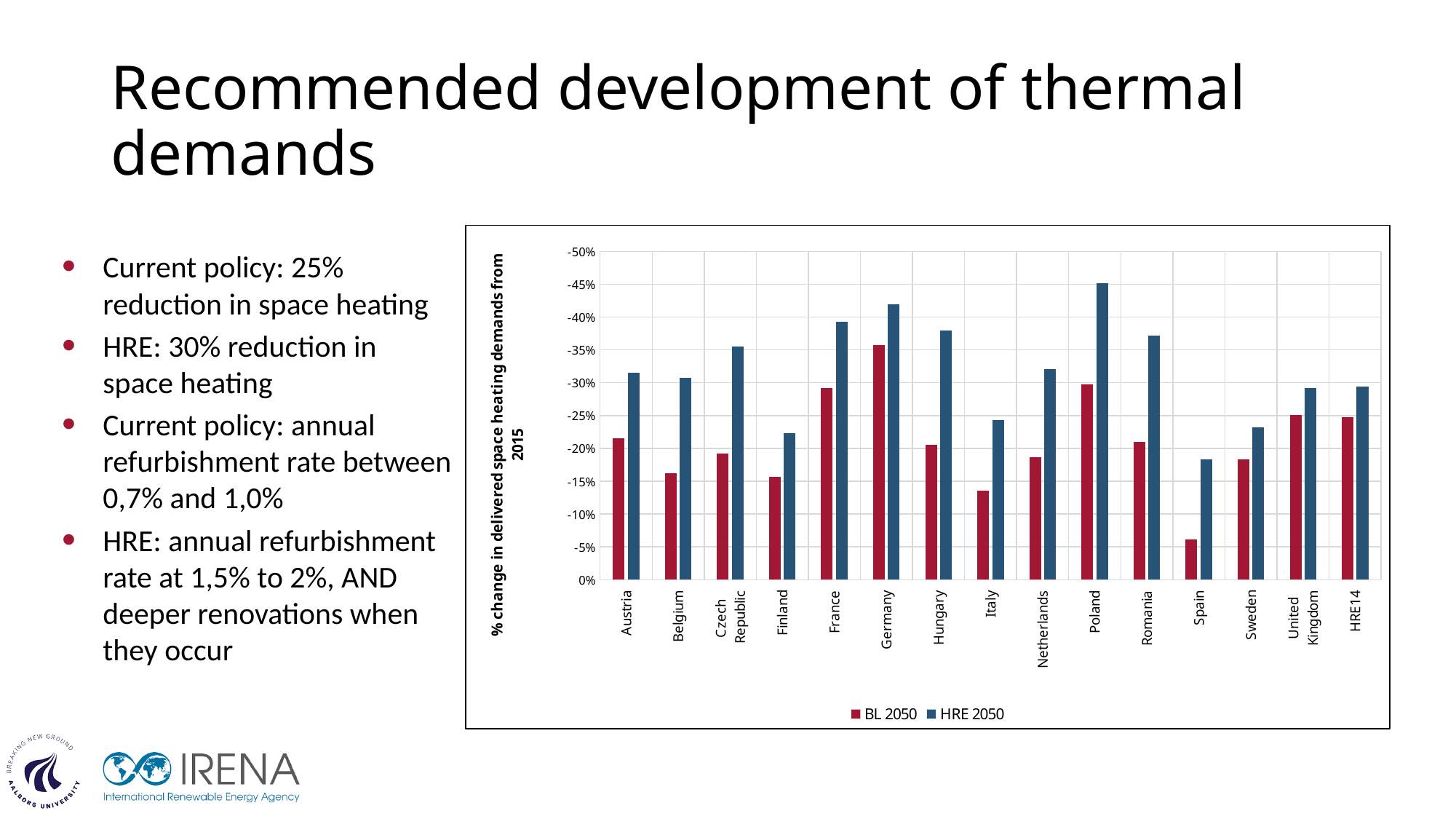
What are the two series named in the chart legend? BL 2050 and HRE 2050 Which category has the shortest HRE 2050 bar (smallest reduction) in the chart? Spain How many series does the chart legend list? 2 What kind of chart is shown on the slide? Bar chart Which shows a larger reduction under HRE 2050: Sweden or Spain? Sweden Which category has the shortest BL 2050 bar (smallest reduction) in the chart? Spain Is the reduction shown for Poland under HRE 2050 larger or smaller than 40%? larger Is the reduction shown for Spain under BL 2050 larger or smaller than 10%? smaller Which category has the tallest BL 2050 bar (largest reduction) in the chart? Germany Which shows a larger reduction under BL 2050: Germany or France? Germany Which category has the tallest HRE 2050 bar (largest reduction) in the chart? Poland How many categories are shown along the x axis of the chart? 15